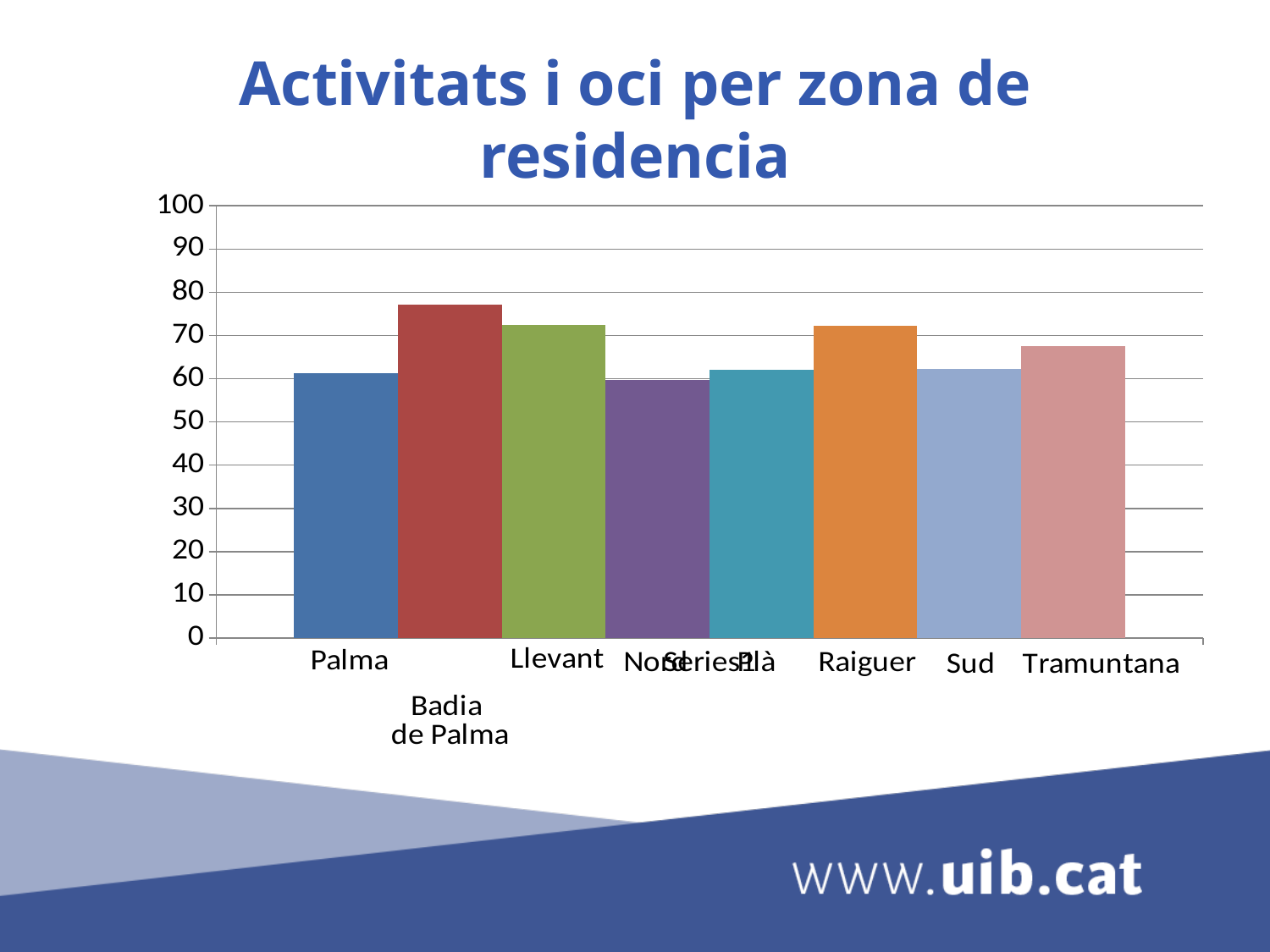
Is the value for Badia de Palma greater or less than 70? greater Which is larger, the value for Palma or the value for Badia de Palma? Badia de Palma Which is larger, the value for Sud or the value for Tramuntana? Tramuntana Is the value for Raiguer greater or less than 80? less Is the value for Palma greater or less than 50? greater Which zone has the highest bar in the chart? Badia de Palma What is the title of the chart on the slide? Activitats i oci per zona de residencia What kind of chart is shown on the slide? bar chart What colour is the bar for Badia de Palma? red How many bars (zones) are plotted in the chart? 8